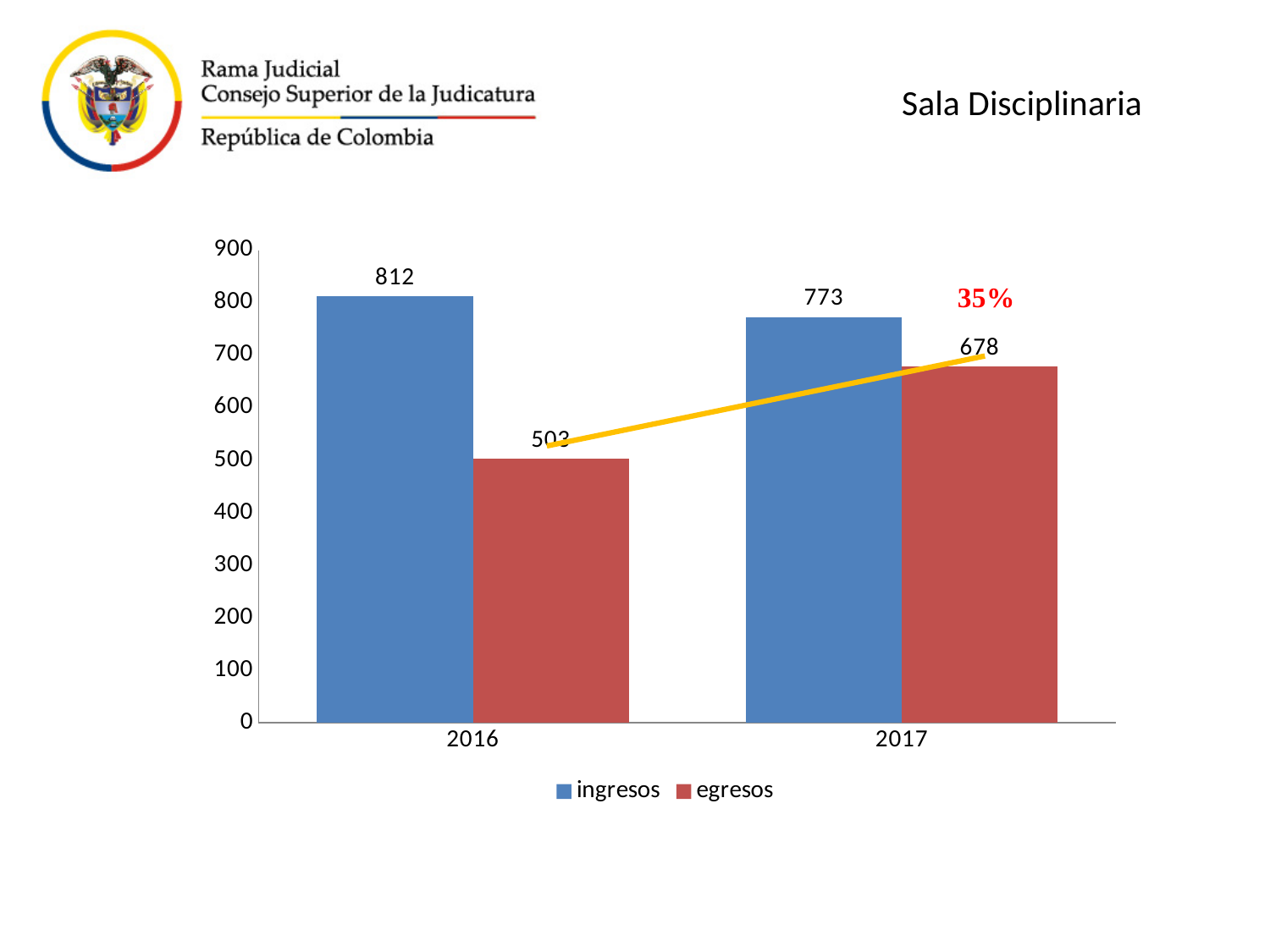
Is the value for egresos in 2016 greater or less than 600? less What is the value of egresos for 2017? 678 Which year has the higher value for ingresos? 2016 What is the difference between ingresos in 2016 and ingresos in 2017? 39 What is the value of ingresos for 2016? 812 Which year has the higher value for egresos? 2017 How many series does the legend list? 2 Do the egresos values rise or fall from 2016 to 2017? rise How many years are shown on the x axis? 2 What type of chart is shown on the slide? bar chart What percentage is written in red next to the yellow line on the chart? 35% What is the value of ingresos for 2017? 773